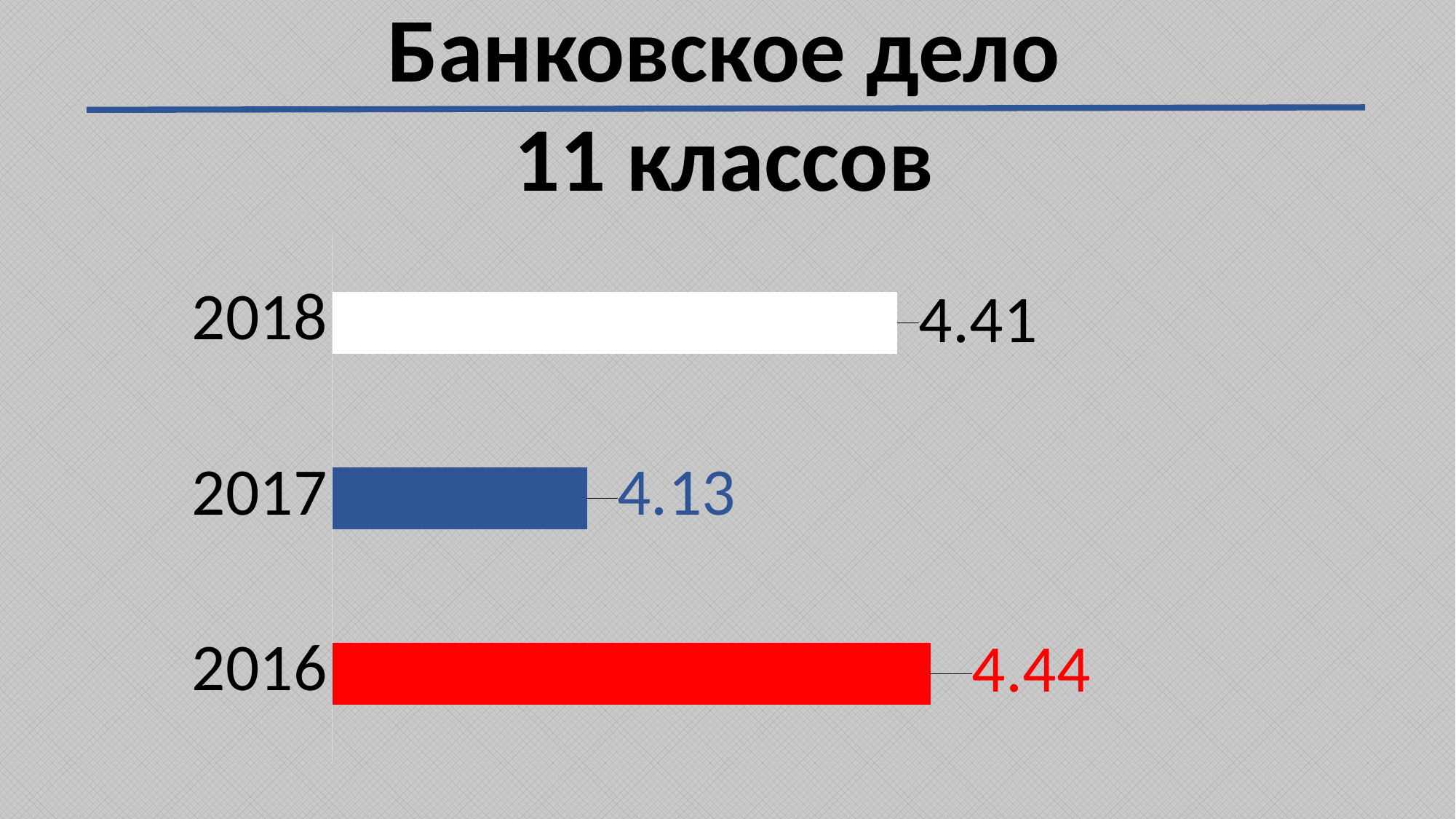
What is the title of the slide? Банковское дело What is the difference between the values for 2016 and 2017? 0.31 How many years are shown in the chart? 3 What is the value for 2016? 4.44 What kind of chart is shown on the slide? bar chart What colour is the bar for 2016? red What is the value for 2018? 4.41 What is the difference between the values for 2018 and 2017? 0.28 Which year has the highest value? 2016 What is the value for 2017? 4.13 Which is larger, the value for 2018 or the value for 2017? 2018 Which year has the lowest value? 2017